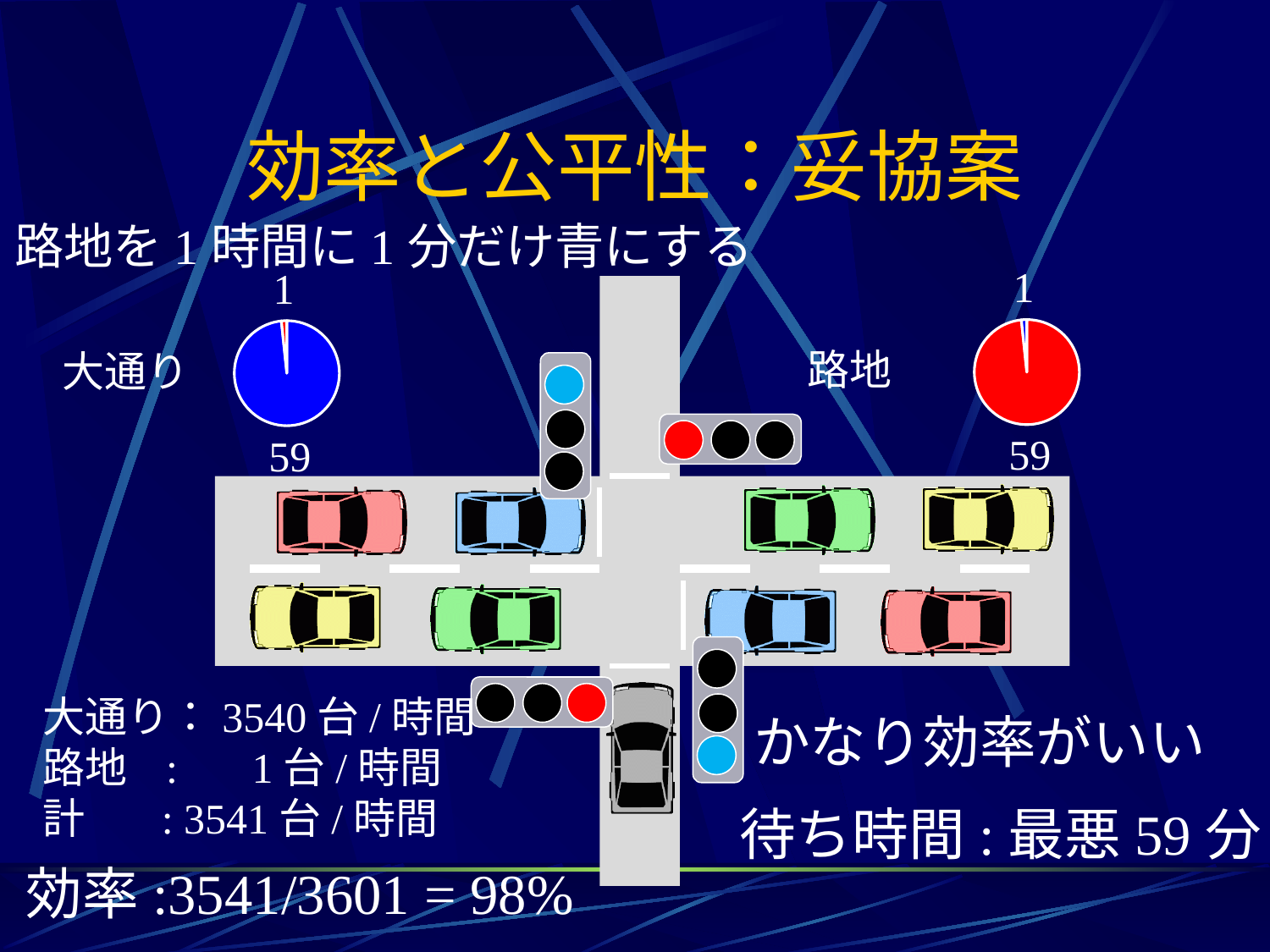
In the 路地 pie chart, what is the value of the large slice? 59 What colour is the 路地 pie chart? red In the 路地 pie chart, what is the total of the two slice values? 60 In the 大通り pie chart, how many slices are there? 2 In the 大通り pie chart, what is the value of the large slice? 59 How many pie charts are on the slide? 2 In the 路地 pie chart, which slice is the largest? 59 In the 大通り pie chart, what is the difference between the two slice values? 58 What kind of chart is shown next to the label 大通り? pie chart In the 大通り pie chart, what is the value of the small slice? 1 In the 路地 pie chart, what is the value of the small slice? 1 What colour is the 大通り pie chart? blue